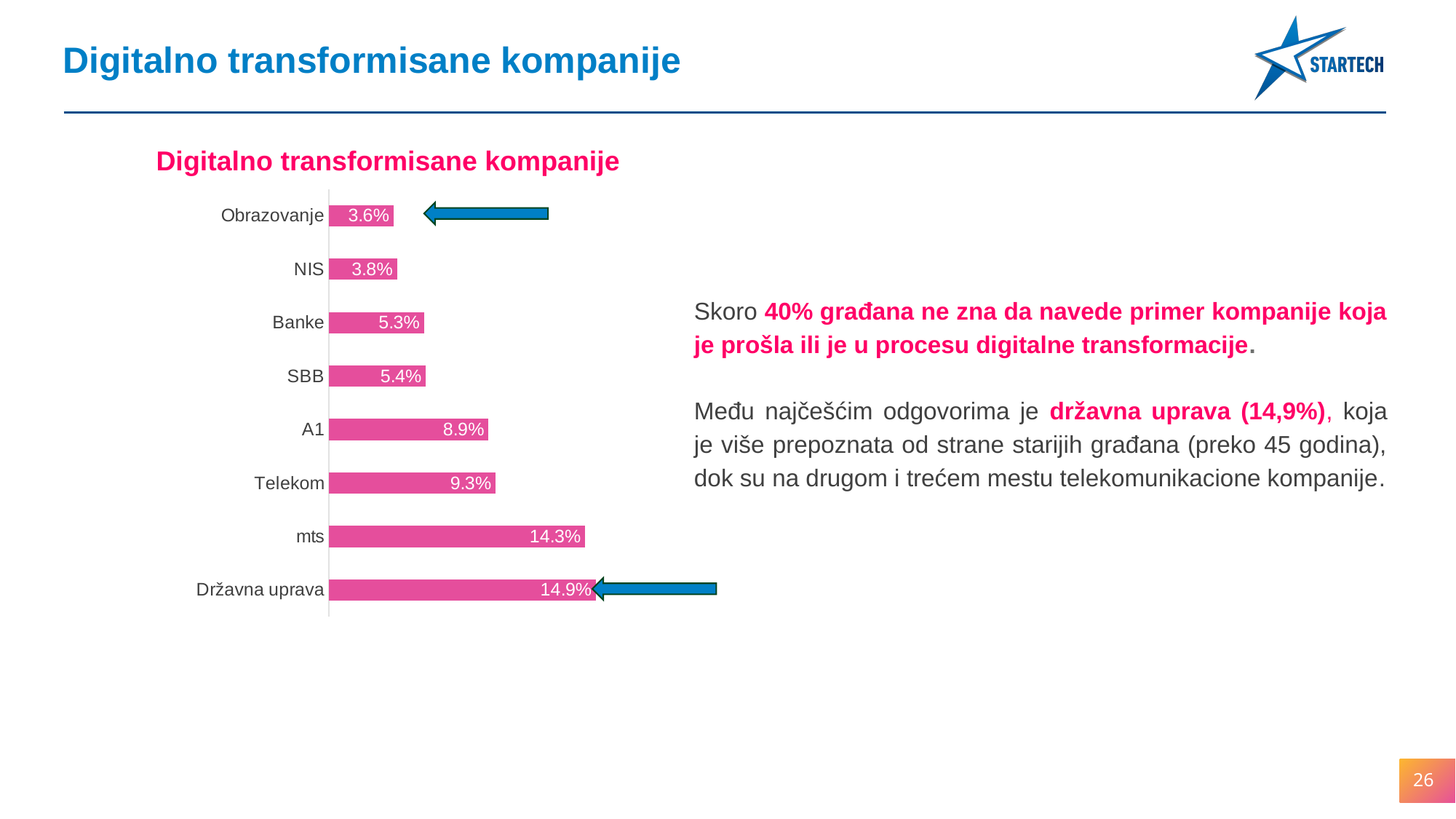
What is the value for Telekom? 9.3% How many categories are shown in the chart? 8 What is the title of the chart? Digitalno transformisane kompanije What is the difference between the values for mts and Telekom? 5.0% What is the value for Državna uprava? 14.9% Which has a larger value, Banke or A1? A1 What is the value for A1? 8.9% What is the difference between the values for Državna uprava and Obrazovanje? 11.3% Which category has the highest value? Državna uprava What is the value for Obrazovanje? 3.6% What kind of chart is shown on the slide? Bar chart Which category has the lowest value? Obrazovanje